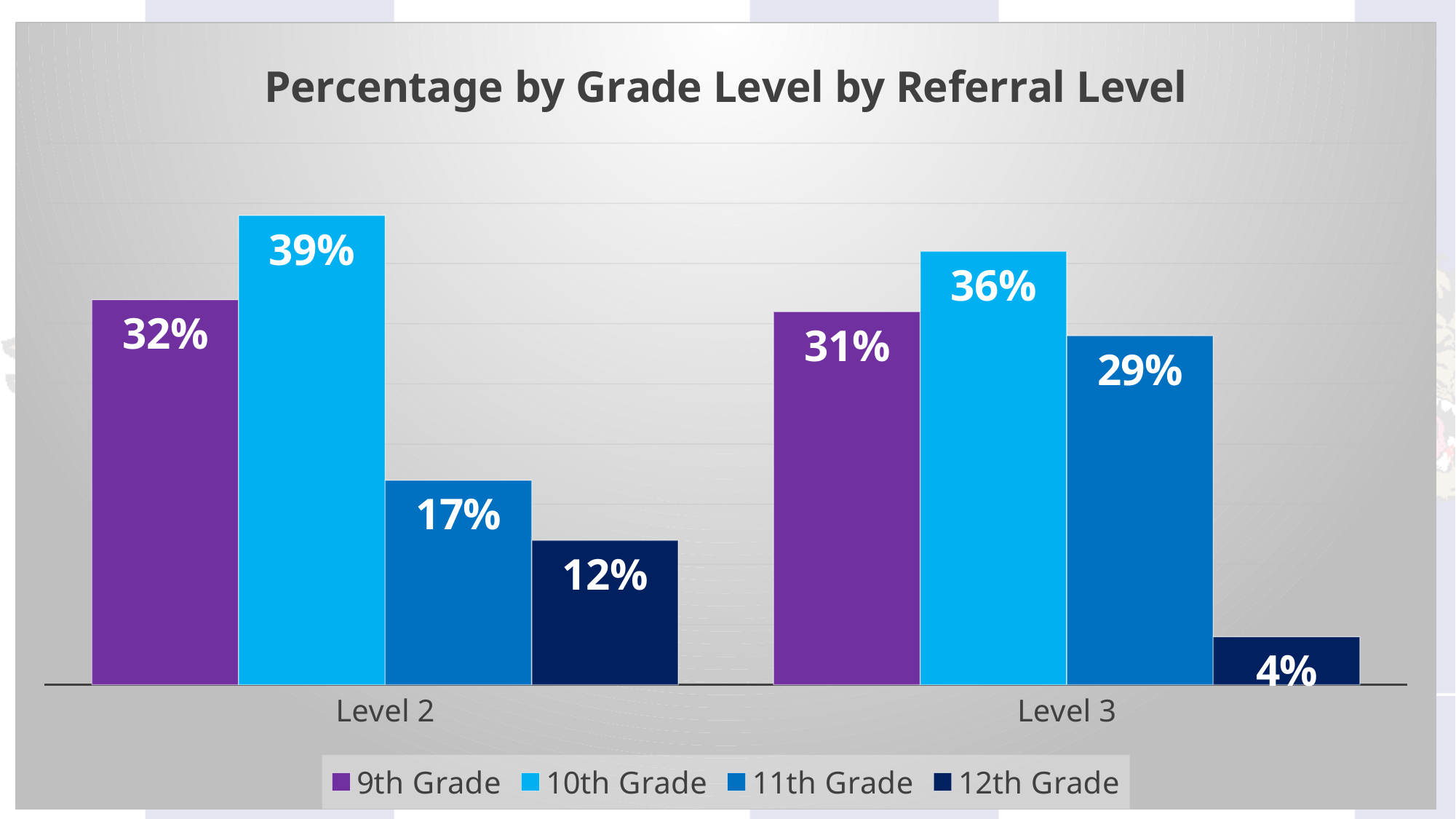
What is the value for 10th Grade at Level 2? 39% What is the difference between the 10th Grade and 11th Grade values at Level 2? 22% What is the difference between the 11th Grade values at Level 3 and Level 2? 12% What kind of chart is shown on the slide? Bar chart Which grade has the lowest percentage at Level 3? 12th Grade What is the value for 12th Grade at Level 3? 4% How many series does the legend list? 4 Which grade has the highest percentage at Level 2? 10th Grade How many referral level categories are shown on the x axis? 2 What is the title of the chart? Percentage by Grade Level by Referral Level Which is larger: the 9th Grade value at Level 2 or the 9th Grade value at Level 3? Level 2 What is the value for 11th Grade at Level 3? 29%